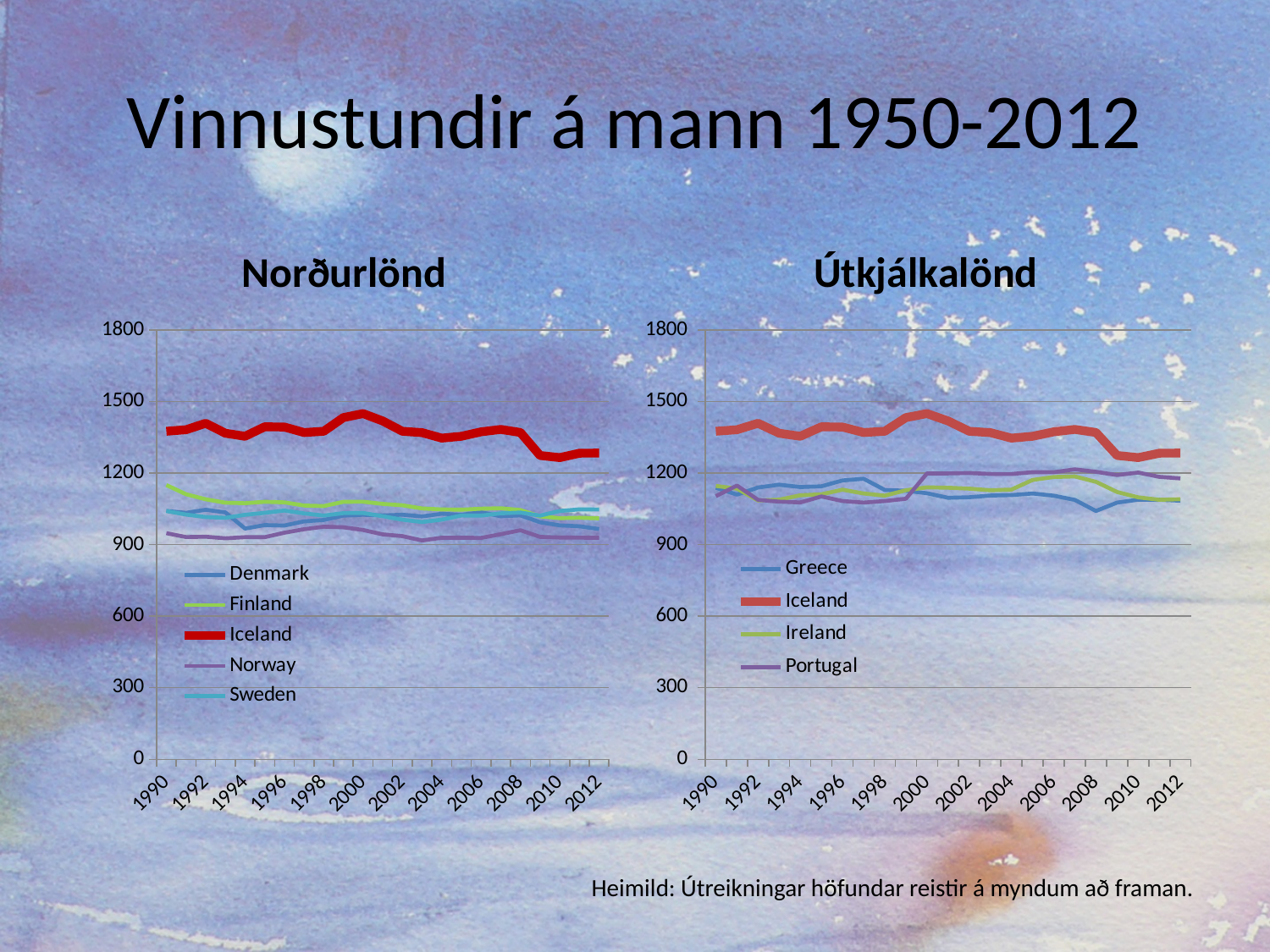
In the Norðurlönd chart, is the value for Norway in 2012 greater or less than 1200? less In the Norðurlönd chart, does the Iceland line generally rise or fall from 1990 to 2012? fall How many series does the legend of the Útkjálkalönd chart list? 4 In the Norðurlönd chart, which country has the highest values throughout the period? Iceland In the Útkjálkalönd chart, is the value for Greece in 2012 greater or less than 1200? less In the Útkjálkalönd chart, which country has the highest values throughout the period? Iceland What is the title of the chart on the right side of the slide? Útkjálkalönd How many series does the legend of the Norðurlönd chart list? 5 In the Norðurlönd chart, which country has the lowest values throughout the period? Norway In the Útkjálkalönd chart, which is larger in 2008, Portugal or Greece? Portugal In the Norðurlönd chart, is the value for Iceland in 2000 greater or less than 1200? greater What kind of chart is the Norðurlönd chart? line chart